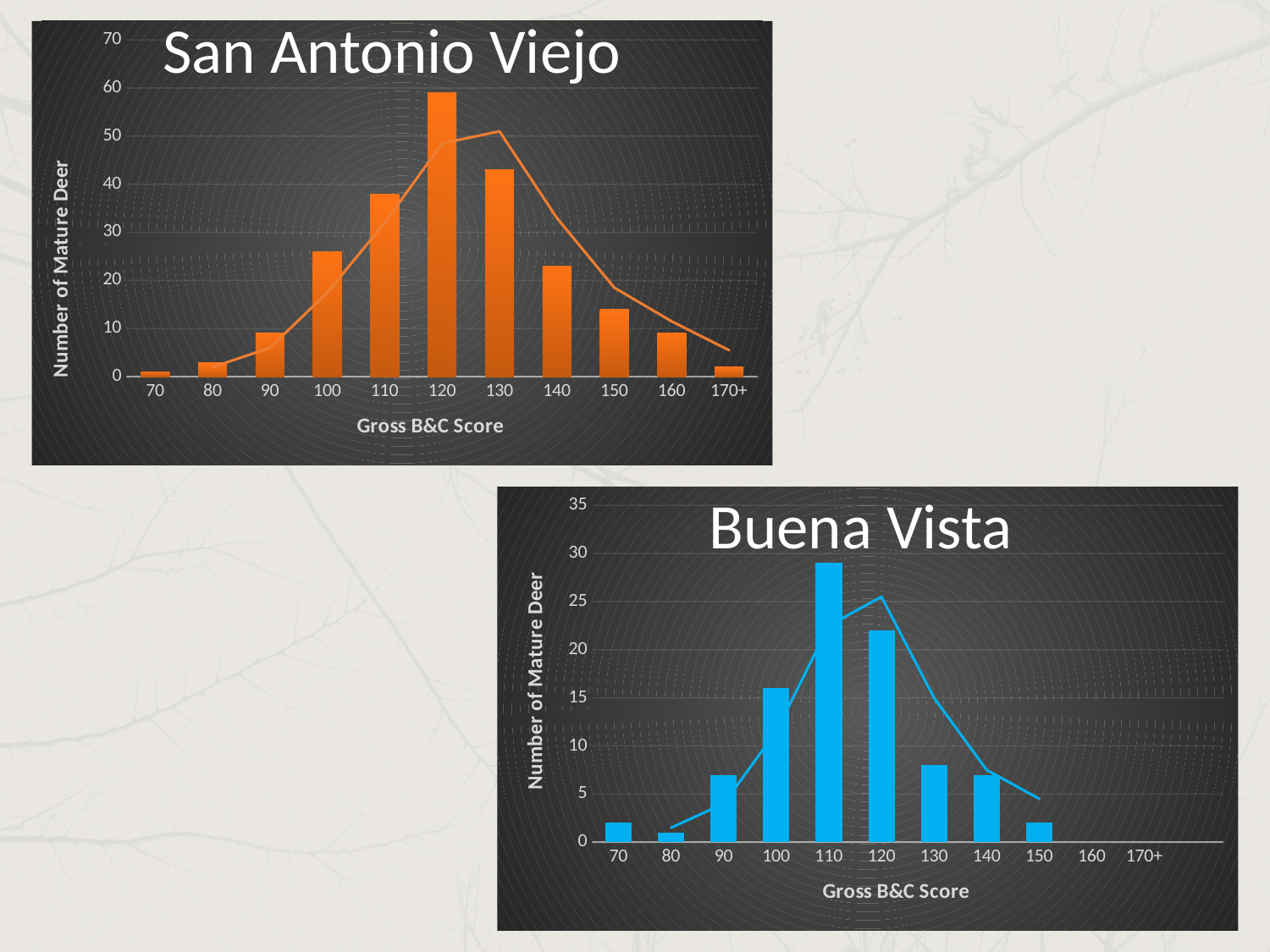
What is the y-axis title of the Buena Vista chart? Number of Mature Deer On the San Antonio Viejo chart, is the value for the 150 category greater or less than 10? greater On the Buena Vista chart, is the value for the 130 category greater or less than 10? less On the San Antonio Viejo chart, is the value for the 110 category greater or less than 30? greater On the San Antonio Viejo chart, which has more mature deer, the 110 category or the 130 category? 130 On the Buena Vista chart, which Gross B&C Score category has the highest number of mature deer? 110 How many Gross B&C Score categories are shown on the x axis of the San Antonio Viejo chart? 11 On the San Antonio Viejo chart, do the bar values rise or fall from the 120 category to the 170+ category? fall On the San Antonio Viejo chart, which Gross B&C Score category has the highest number of mature deer? 120 On the Buena Vista chart, which has more mature deer, the 100 category or the 120 category? 120